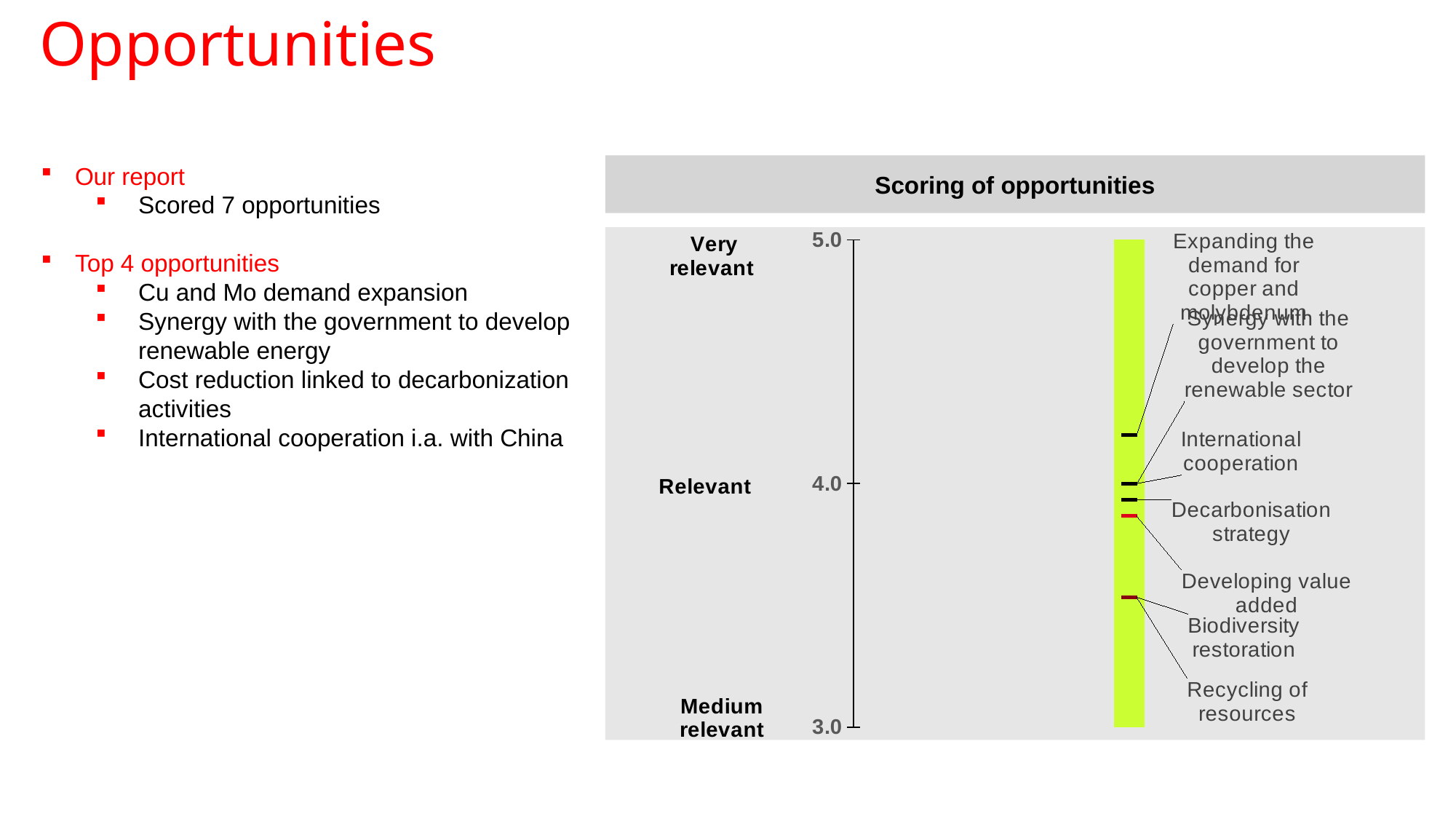
Is the score for Decarbonisation strategy greater or less than 4.0? less Which opportunity has the highest score on the chart? Expanding the demand for copper and molybdenum Is the score for Recycling of resources greater or less than 4.0? less How many opportunities are labelled on the chart? 7 Which scores higher, Expanding the demand for copper and molybdenum or Biodiversity restoration? Expanding the demand for copper and molybdenum Which relevance label corresponds to the 4.0 mark on the axis? Relevant What is the lowest value shown on the chart's vertical axis? 3.0 Is the score for Developing value added greater or less than 5.0? less What is the highest value shown on the chart's vertical axis? 5.0 What is the title of the chart? Scoring of opportunities Which relevance label corresponds to the 3.0 mark on the axis? Medium relevant